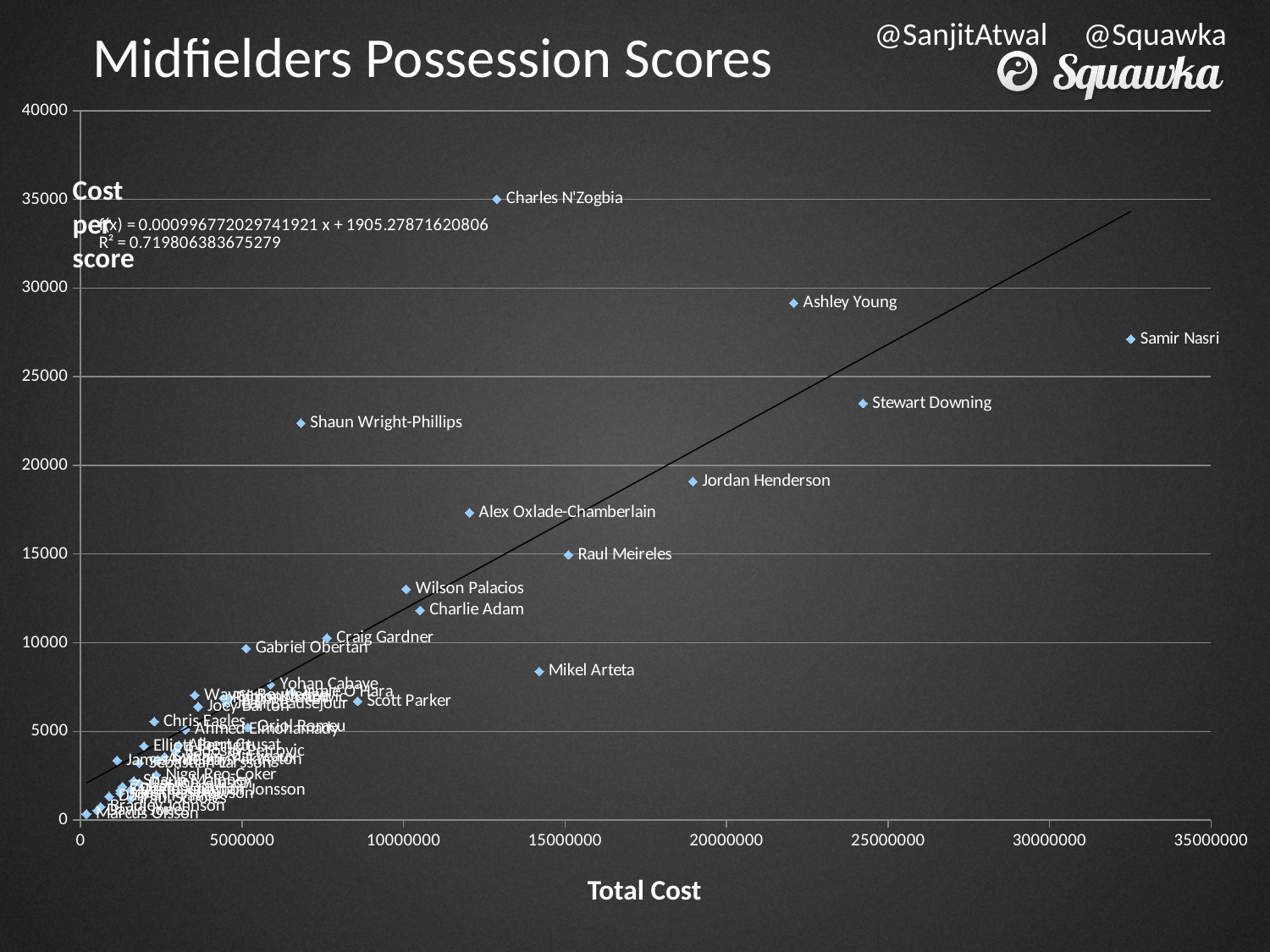
What is the title of the chart? Midfielders Possession Scores Is the cost per score for Jordan Henderson greater or less than 20000? less Is the cost per score for Ashley Young greater or less than 25000? greater Is the cost per score for Stewart Downing greater or less than 25000? less Does the fitted trend line rise or fall as total cost increases? Rise Who has the higher cost per score, Wilson Palacios or Mikel Arteta? Wilson Palacios Which player has the highest cost per score? Charles N'Zogbia What kind of chart is shown on the slide? Scatter chart Which player has the highest total cost (the rightmost point)? Samir Nasri What is the label of the horizontal axis? Total Cost Who has the higher cost per score, Ashley Young or Stewart Downing? Ashley Young